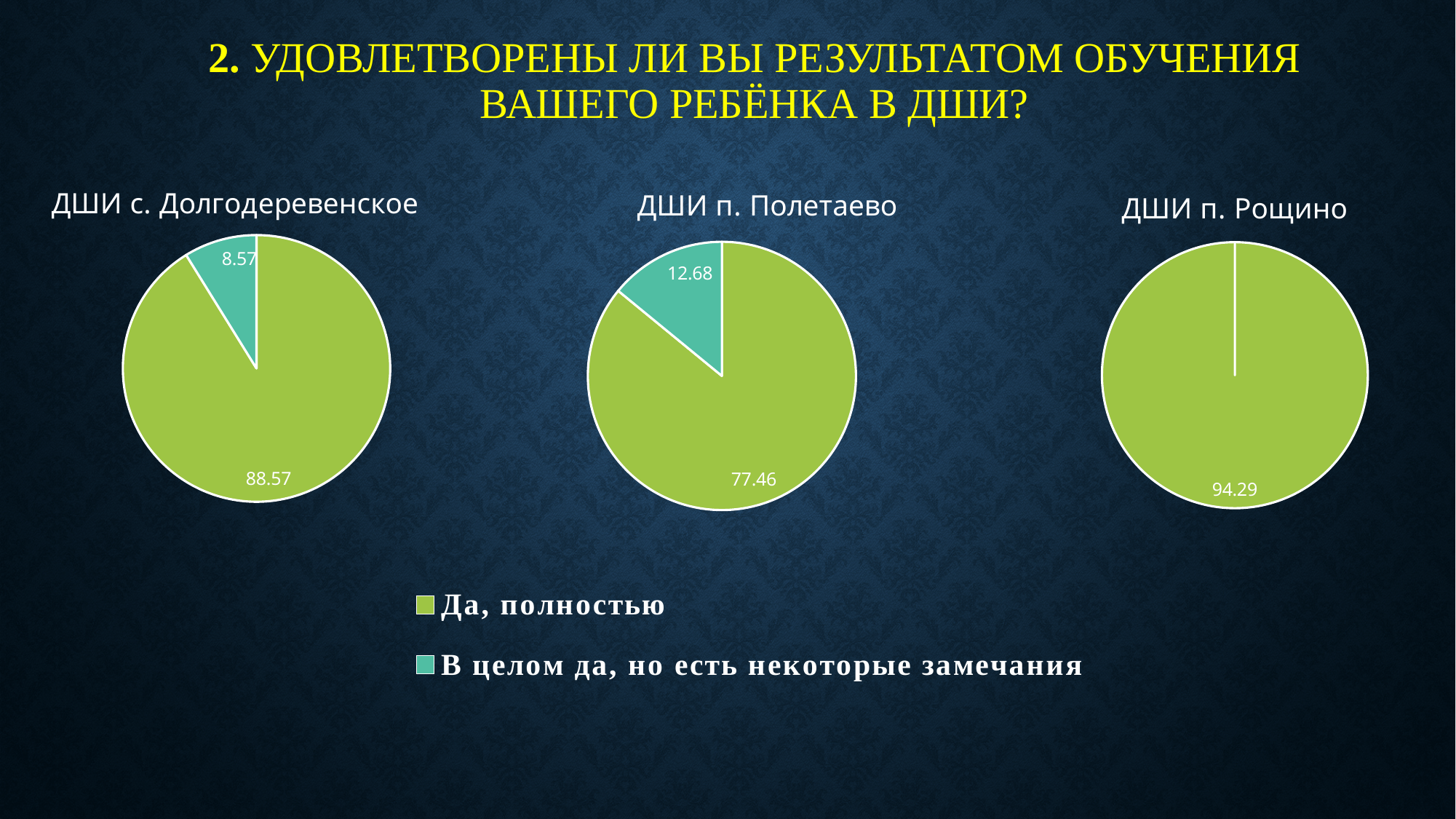
In the pie chart titled "ДШИ с. Долгодеревенское", what is the value for "Да, полностью"? 88.57 How many entries does the shared legend list? 2 Which colour represents "Да, полностью" in the pie charts? Green In the pie chart titled "ДШИ п. Рощино", what is the value for "Да, полностью"? 94.29 Which is larger: the "В целом да, но есть некоторые замечания" value in the "ДШИ с. Долгодеревенское" chart or in the "ДШИ п. Полетаево" chart? ДШИ п. Полетаево In the pie chart titled "ДШИ п. Полетаево", what is the value for "Да, полностью"? 77.46 In the pie chart titled "ДШИ п. Полетаево", what is the value for "В целом да, но есть некоторые замечания"? 12.68 What kind of chart is used for "ДШИ п. Полетаево"? Pie chart In the pie chart titled "ДШИ п. Полетаево", what is the difference between the "Да, полностью" value and the "В целом да, но есть некоторые замечания" value? 64.78 Across the three pie charts, which school has the lowest value for "Да, полностью"? ДШИ п. Полетаево Across the three pie charts, which school has the highest value for "Да, полностью"? ДШИ п. Рощино In the pie chart titled "ДШИ с. Долгодеревенское", what is the value for "В целом да, но есть некоторые замечания"? 8.57